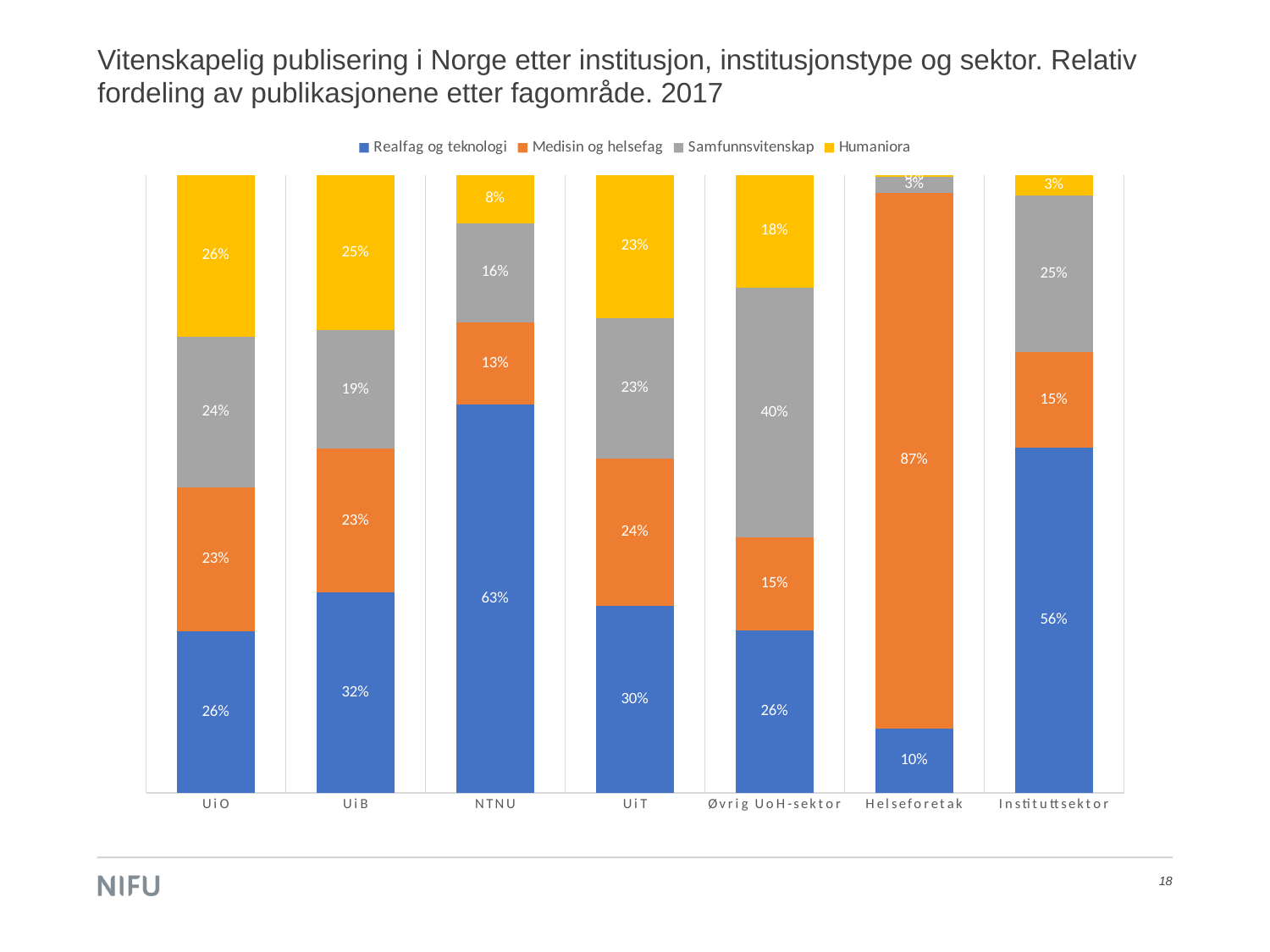
How many series does the legend list? 4 Which institution or sector has the highest share of Realfag og teknologi? NTNU What is the share of Humaniora for Instituttsektor? 3% What kind of chart is shown on the slide? Stacked bar chart Which has a larger share of Medisin og helsefag, UiT or Øvrig UoH-sektor? UiT How many institutions or sectors are shown along the x axis? 7 What is the difference between the Humaniora share for UiO and for NTNU? 18 percentage points Which institution or sector has the lowest share of Realfag og teknologi? Helseforetak What is the share of Medisin og helsefag for Helseforetak? 87% Which colour represents Humaniora in the chart? Yellow What is the share of Samfunnsvitenskap for Øvrig UoH-sektor? 40% What is the share of Realfag og teknologi for NTNU? 63%